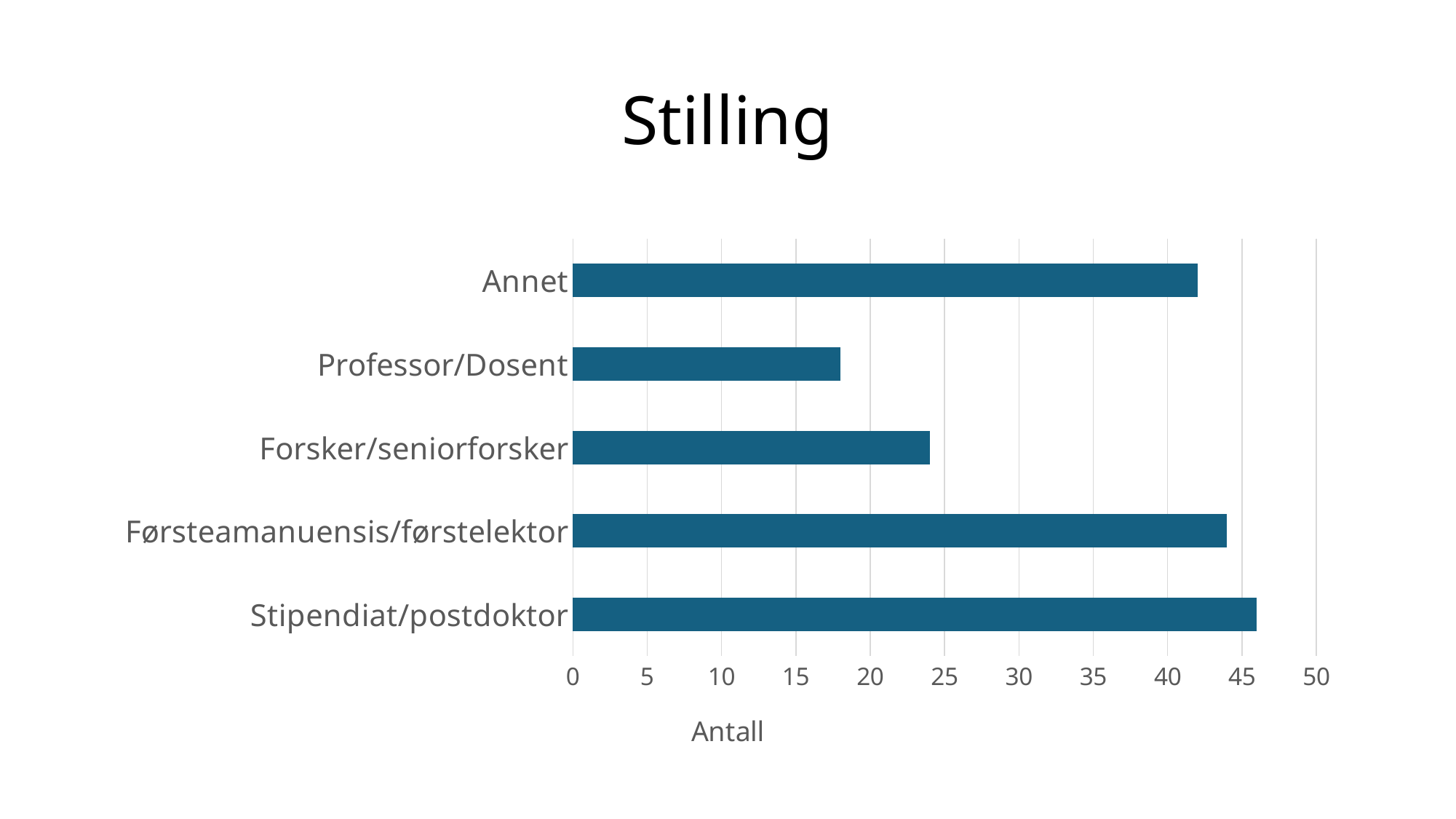
Which category has the highest value? Stipendiat/postdoktor Is the value for Stipendiat/postdoktor greater or less than 50? less Is the value for Annet greater or less than 40? greater Which category has the lowest value? Professor/Dosent What is the title of the chart? Stilling What kind of chart is shown on the slide? bar chart How many categories are shown in the chart? 5 Is the value for Professor/Dosent greater or less than 20? less Which has the larger value, Forsker/seniorforsker or Professor/Dosent? Forsker/seniorforsker Which has the larger value, Annet or Forsker/seniorforsker? Annet What is the label on the horizontal axis of the chart? Antall